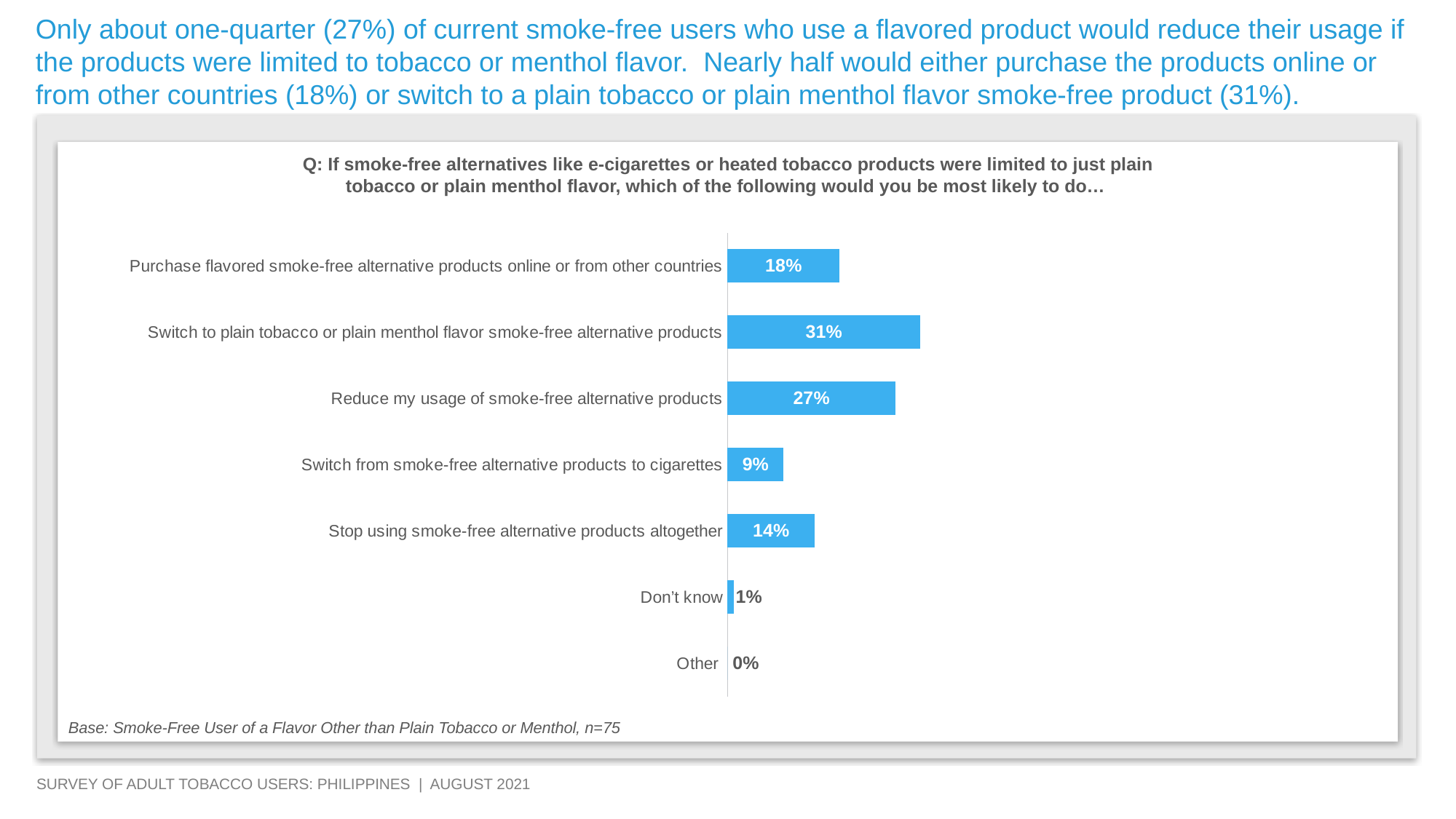
How many response categories are shown in the chart? 7 What percentage of respondents answered 'Don't know'? 1% Which response option has the lowest percentage? Other What is the difference in percentage points between 'Reduce my usage of smoke-free alternative products' and 'Switch from smoke-free alternative products to cigarettes'? 18 percentage points Which is larger: the percentage for 'Stop using smoke-free alternative products altogether' or for 'Switch from smoke-free alternative products to cigarettes'? Stop using smoke-free alternative products altogether What percentage of respondents would switch to plain tobacco or plain menthol flavor smoke-free alternative products? 31% What is the combined percentage of respondents who would purchase flavored products online or from other countries and those who would switch to plain tobacco or plain menthol flavor products? 49% What type of chart is shown on the slide? Bar chart What percentage of respondents would stop using smoke-free alternative products altogether? 14% What is the base sample size (n) stated below the chart? n=75 What percentage of respondents would purchase flavored smoke-free alternative products online or from other countries? 18% Which response option has the highest percentage? Switch to plain tobacco or plain menthol flavor smoke-free alternative products